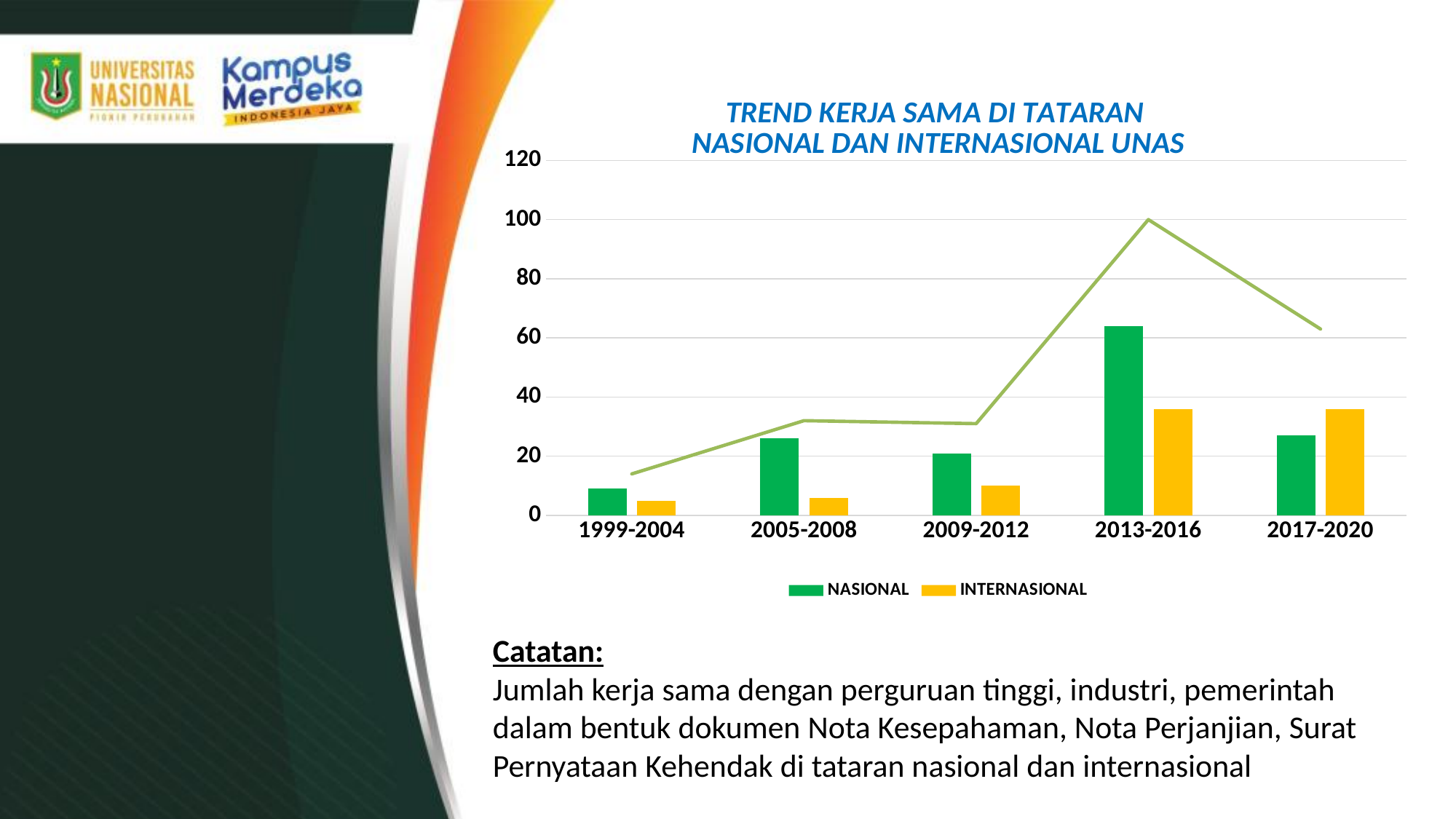
Is the NASIONAL value for 2013-2016 greater or less than 40? greater What kind of chart is shown on the slide? combination bar and line chart In which period is the NASIONAL value lowest? 1999-2004 Is the NASIONAL value for 2005-2008 greater or less than 20? greater How many periods are shown on the x axis? 5 For 2005-2008, which is larger, NASIONAL or INTERNASIONAL? NASIONAL In which period is the NASIONAL value highest? 2013-2016 Is the INTERNASIONAL value for 2009-2012 greater or less than 20? less How many series does the legend list? 2 For 2017-2020, which is larger, NASIONAL or INTERNASIONAL? INTERNASIONAL Does the NASIONAL value rise or fall from 2009-2012 to 2013-2016? rise What colour are the NASIONAL bars? green